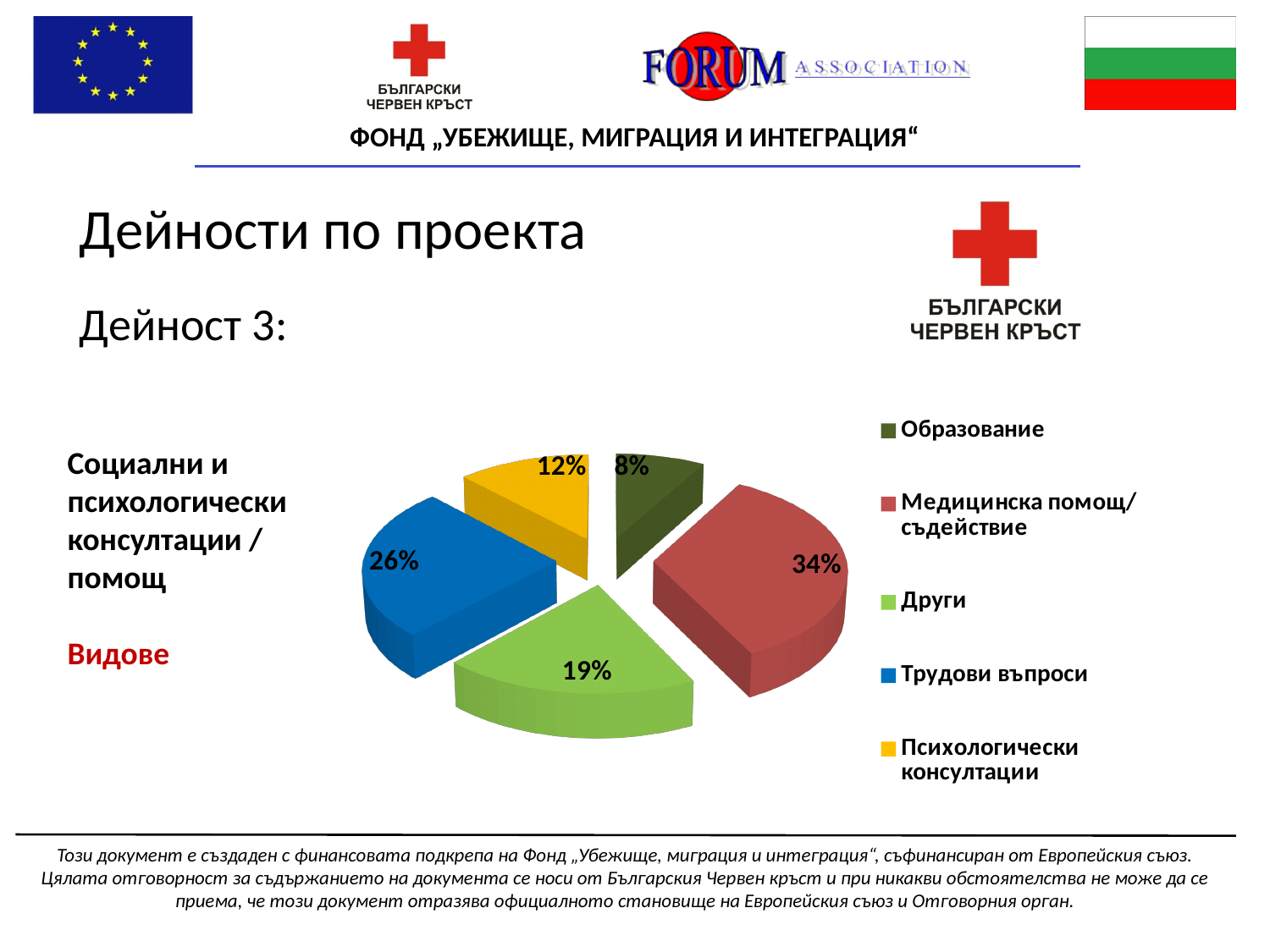
How many categories does the pie chart have? 5 What is the difference in percentage points between "Медицинска помощ/съдействие" and "Трудови въпроси"? 8 What share of the pie does "Медицинска помощ/съдействие" represent? 34% Which category has the smallest share of the pie? Образование What share of the pie does "Трудови въпроси" represent? 26% What colour is the slice for "Трудови въпроси"? Blue What share of the pie does "Образование" represent? 8% What share of the pie does "Психологически консултации" represent? 12% What type of chart is shown on the slide? Pie chart What share of the pie does "Други" represent? 19% Which category has the largest share of the pie? Медицинска помощ/съдействие Which is larger: the share for "Други" or the share for "Психологически консултации"? Други